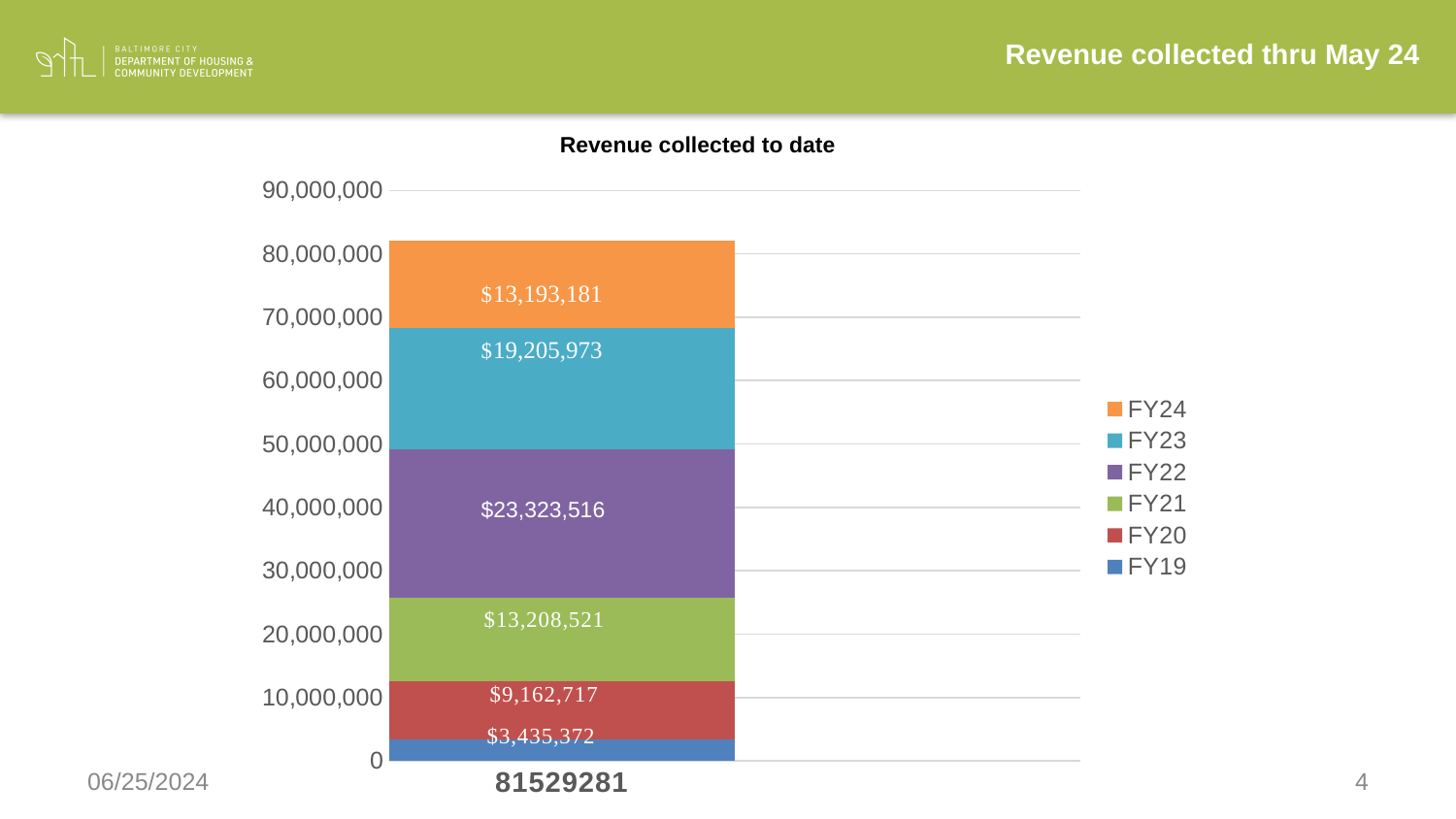
Which fiscal year has the lowest revenue collected? FY19 What is the title of the chart? Revenue collected to date Which is larger, the value for FY22 or the value for FY23? FY22 What is the value for FY20? $9,162,717 What is the value for FY22? $23,323,516 What is the value for FY19? $3,435,372 What is the difference between the FY23 and FY24 values? $6,012,792 What is the value for FY24? $13,193,181 How many series does the legend list? 6 Which fiscal year has the highest revenue collected? FY22 What label is printed beneath the bar on the x axis? 81529281 What type of chart is shown on the slide? Stacked bar chart